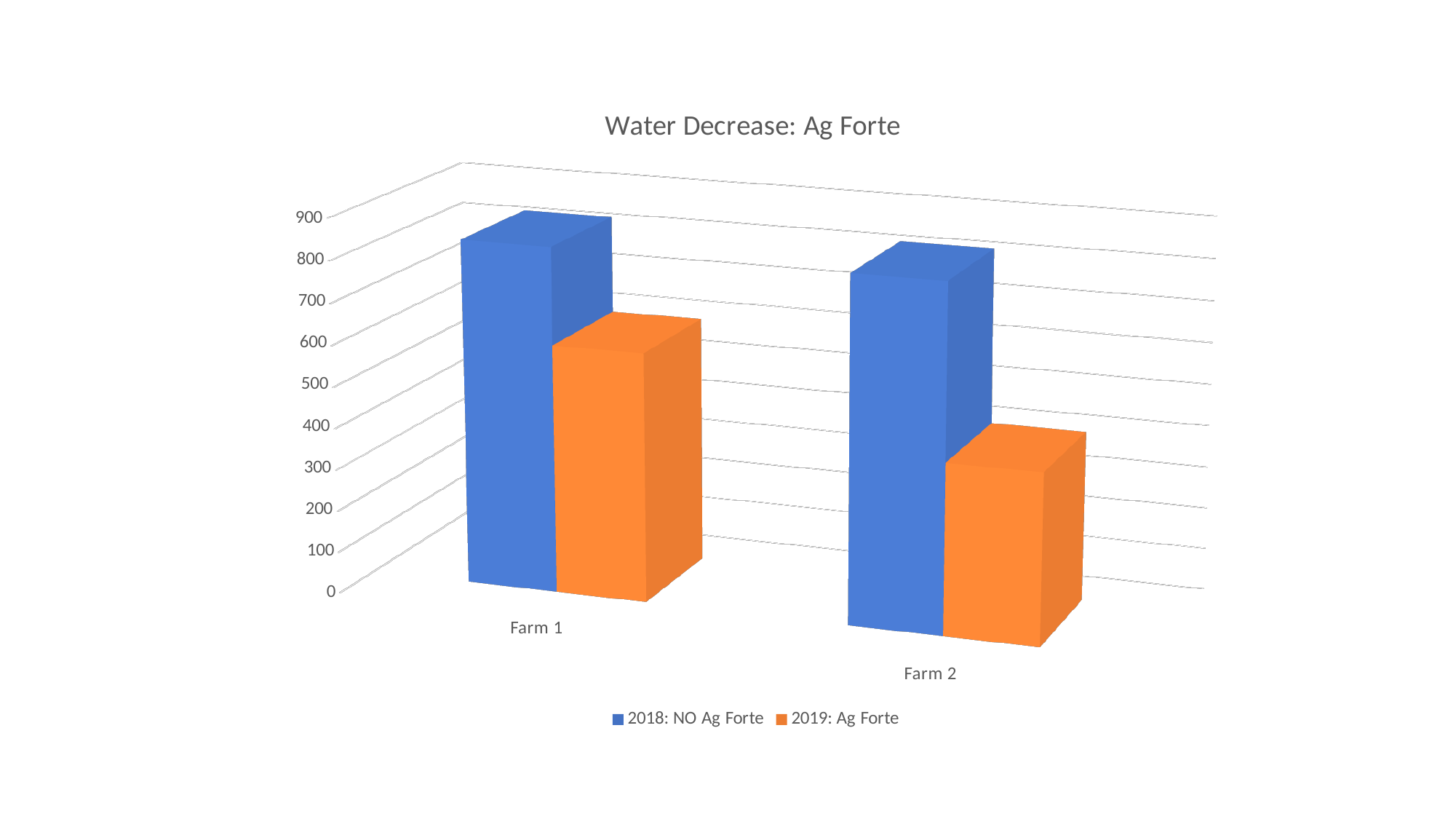
How many farms (categories) are shown on the x axis? 2 Which farm has the lowest value for the 2019: Ag Forte series? Farm 2 For Farm 1, which is larger: the 2018: NO Ag Forte value or the 2019: Ag Forte value? 2018: NO Ag Forte Is the 2018: NO Ag Forte value for Farm 2 greater or less than 600? greater Does the 2019: Ag Forte series rise or fall from Farm 1 to Farm 2? fall What kind of chart is shown on the slide? bar chart Is the 2019: Ag Forte value for Farm 2 greater or less than 500? less What is the title of the chart? Water Decrease: Ag Forte Which series is shown in orange? 2019: Ag Forte How many series does the legend list? 2 Is the 2018: NO Ag Forte value for Farm 1 greater or less than 700? greater